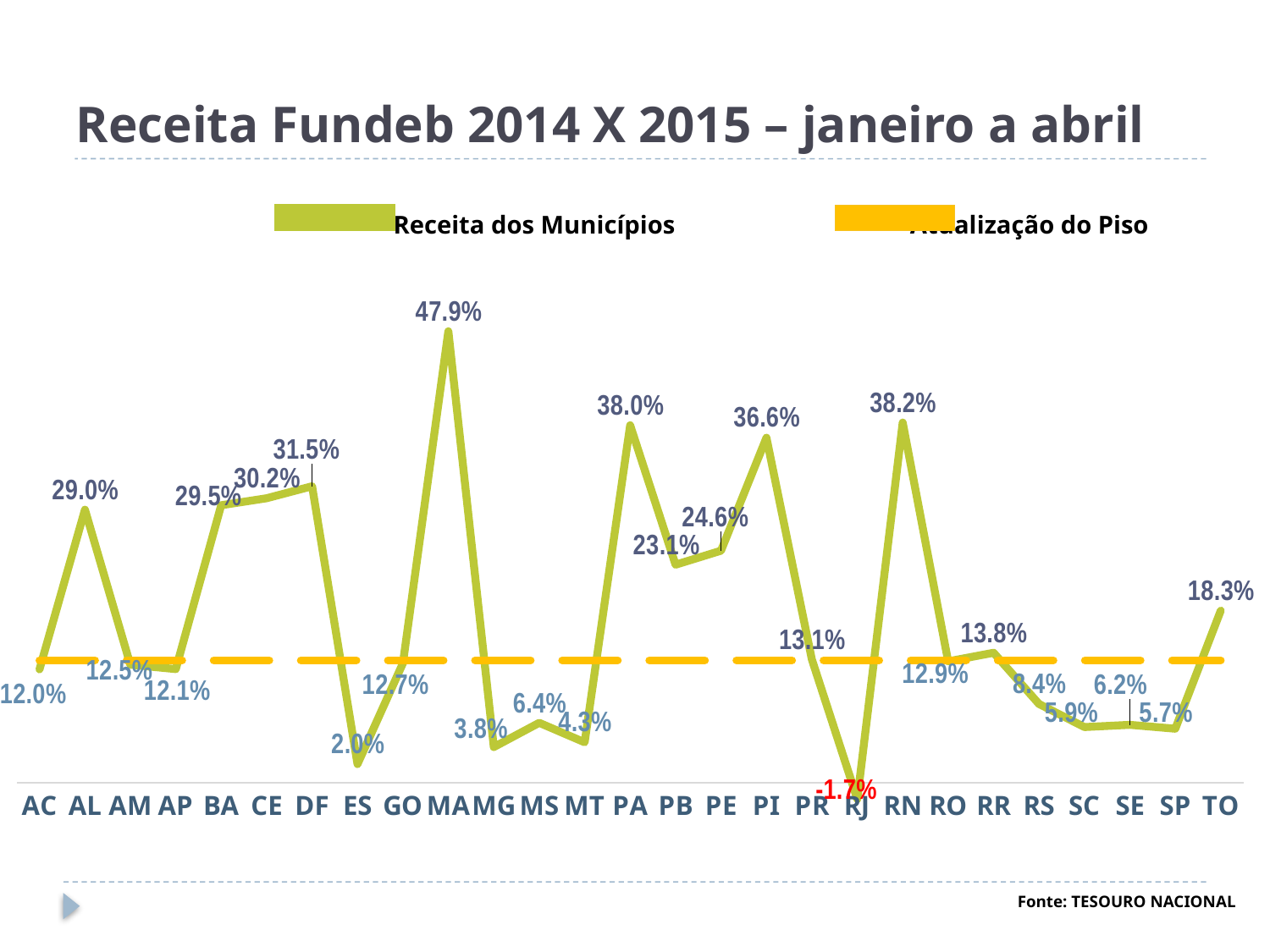
How many states (categories) are shown on the x axis? 27 What type of chart is shown on the slide? Line chart Which has a larger Receita dos Municípios value, AL or DF? DF What is the Receita dos Municípios value for TO? 18.3% What is the difference between the Receita dos Municípios values for MA and RN? 9.7 percentage points How many series does the legend list? 2 What is the Receita dos Municípios value for RJ? -1.7% Which state has the lowest Receita dos Municípios value? RJ Which state has the highest Receita dos Municípios value? MA What is the Receita dos Municípios value for MA? 47.9% What is the Receita dos Municípios value for DF? 31.5% What is the title of the chart? Receita Fundeb 2014 X 2015 – janeiro a abril